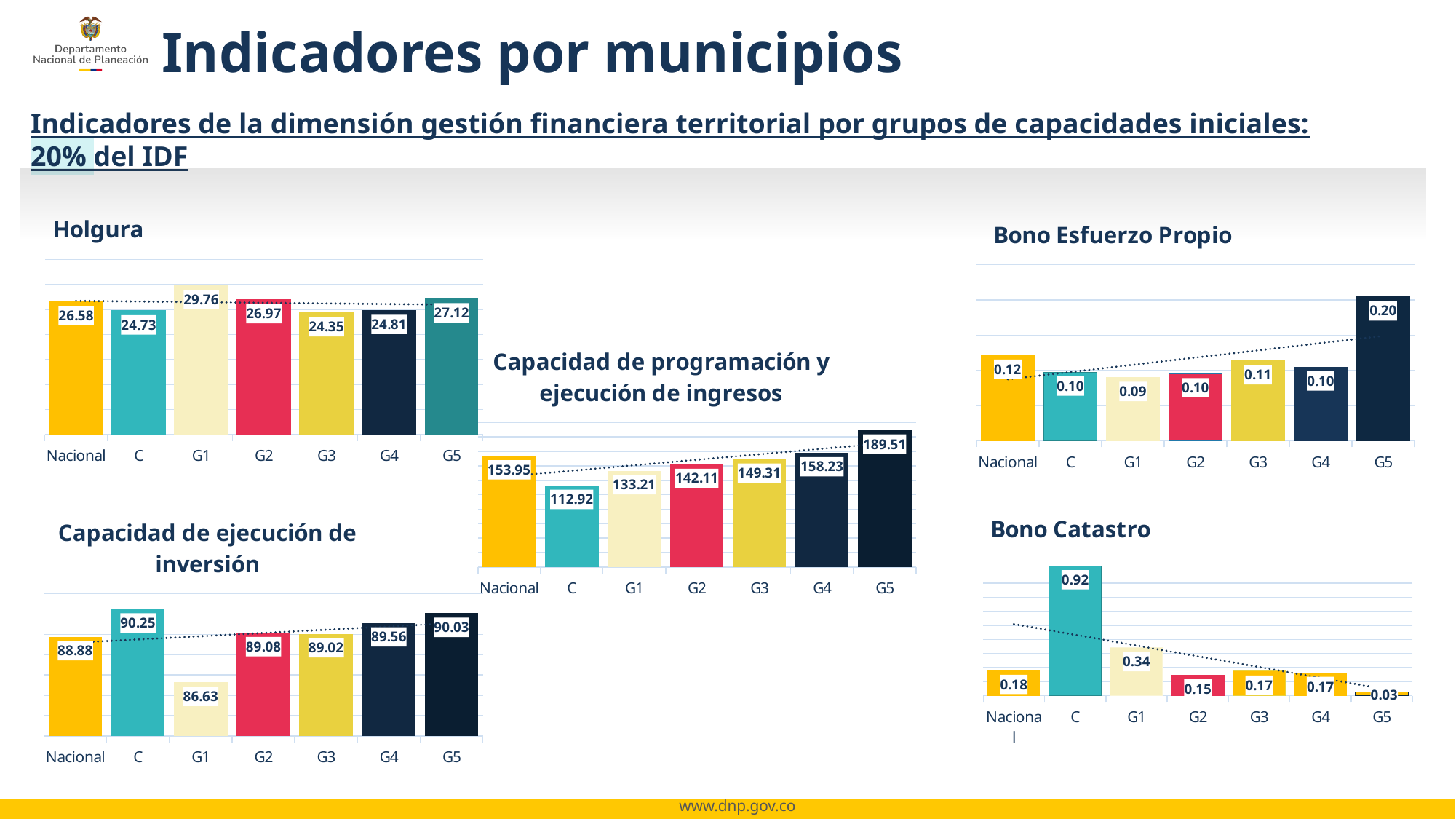
In the 'Capacidad de programación y ejecución de ingresos' chart, what is the difference between G5 and C? 76.59 How many categories are shown on the x axis of the 'Holgura' chart? 7 In the 'Holgura' chart, which category has the lowest value? G3 In the 'Bono Catastro' chart, what is the value for C? 0.92 In the 'Bono Catastro' chart, what is the difference between C and G5? 0.89 In the 'Capacidad de ejecución de inversión' chart, which is larger, the value for C or the value for G5? C In the 'Holgura' chart, what is the value for G1? 29.76 In the 'Capacidad de programación y ejecución de ingresos' chart, what is the value for Nacional? 153.95 In the 'Bono Esfuerzo Propio' chart, which category has the lowest value? G1 In the 'Bono Esfuerzo Propio' chart, what is the value for G5? 0.20 In the 'Capacidad de programación y ejecución de ingresos' chart, which category has the highest value? G5 In the 'Capacidad de ejecución de inversión' chart, what is the value for G1? 86.63